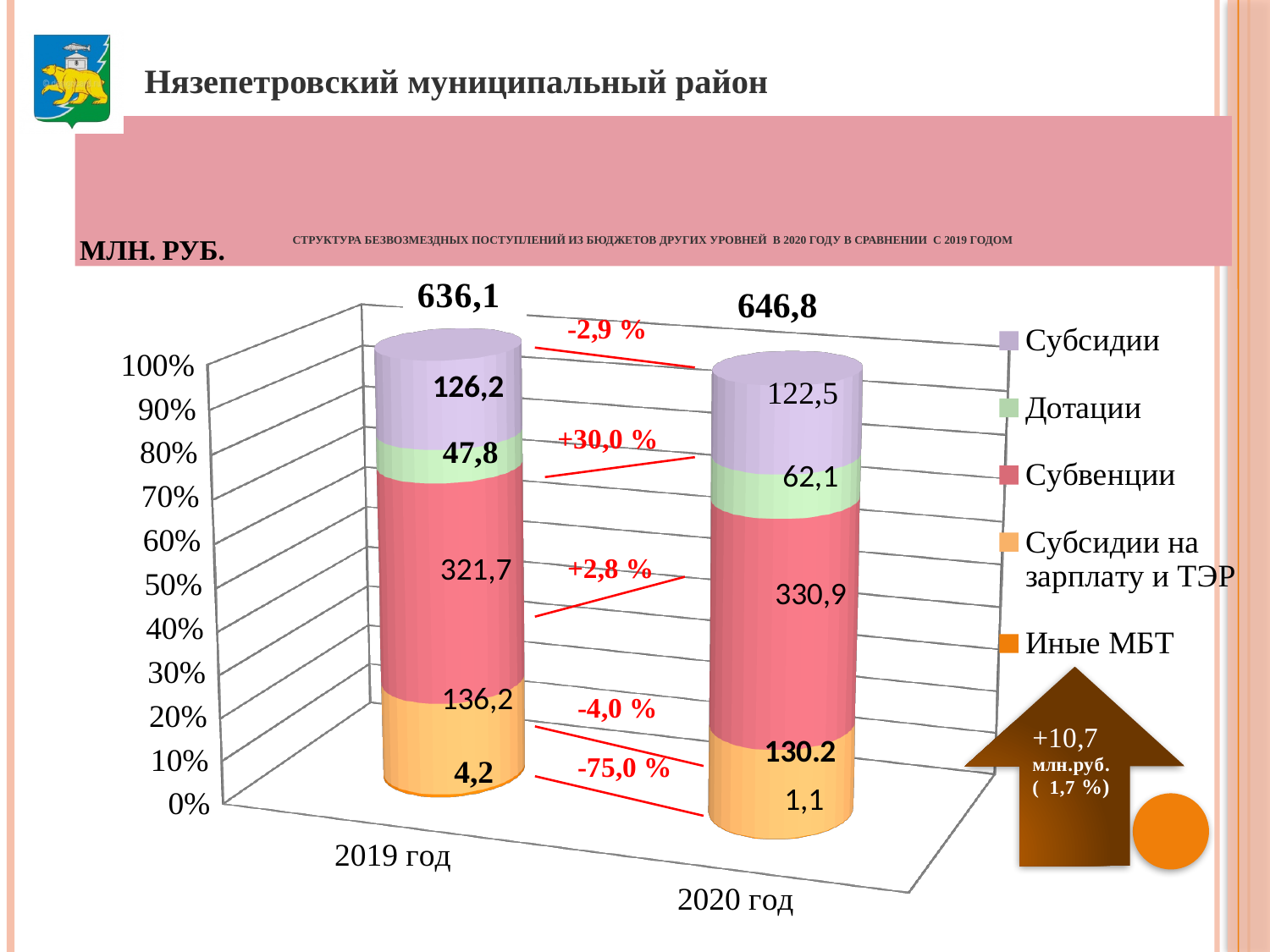
What kind of chart is shown on the slide? Stacked bar chart What is the value of Дотации for 2020 год? 62,1 Which series has the largest value in the 2019 год bar? Субвенции What is the value of Субвенции for 2019 год? 321,7 What is the total shown above the bar for 2020 год? 646,8 Is the value of Дотации larger in 2019 год or 2020 год? 2020 год What is the total shown above the bar for 2019 год? 636,1 What is the value of Субвенции for 2020 год? 330,9 What is the value of Иные МБТ for 2019 год? 4,2 Which series has the smallest value in the 2020 год bar? Иные МБТ How many series does the legend list? 5 What is the value of Субсидии for 2020 год? 122,5